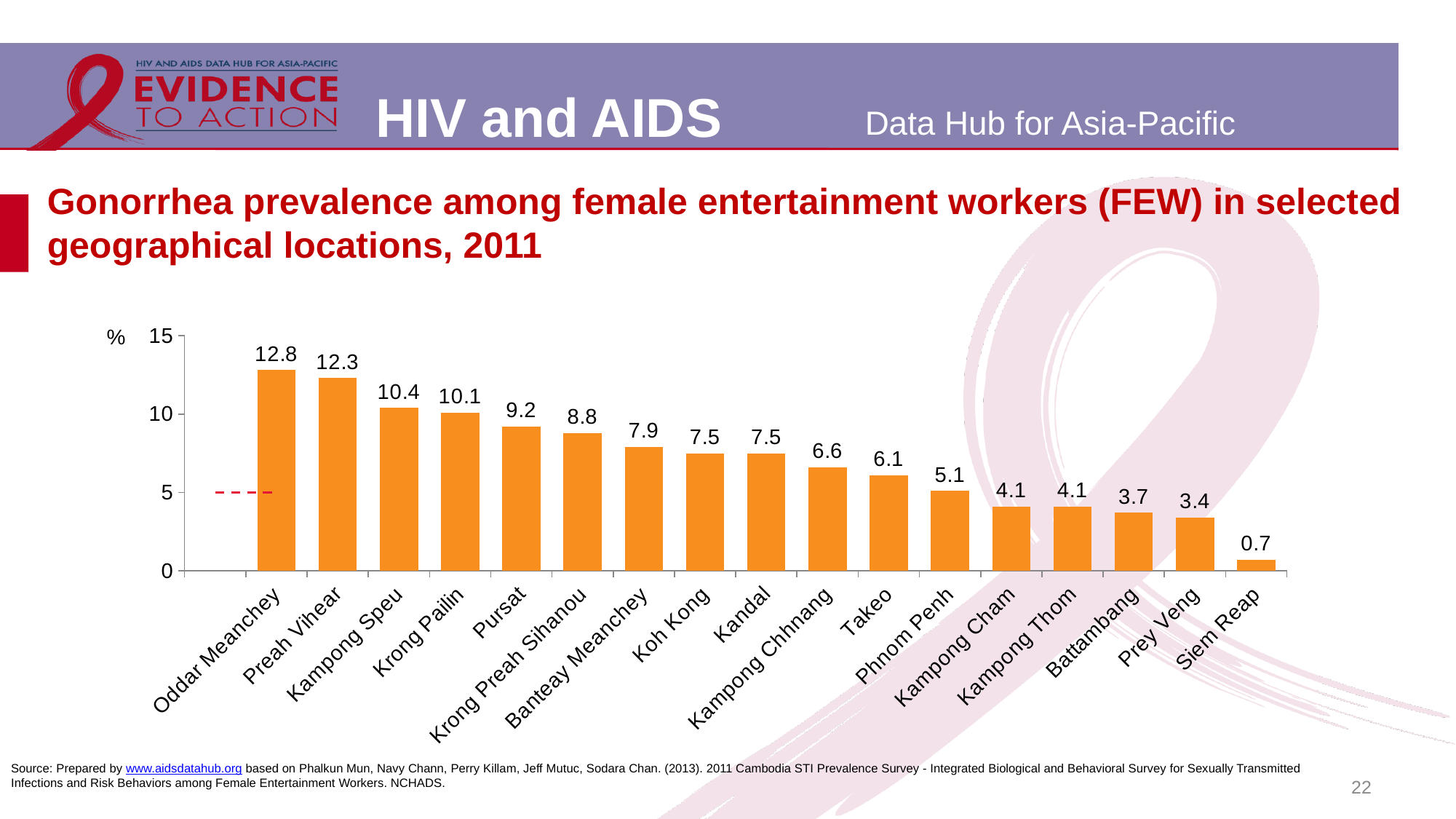
Which has a higher value, Pursat or Battambang? Pursat Which location has the lowest gonorrhea prevalence? Siem Reap What type of chart is used on this slide? Bar chart What is the difference between the values for Kampong Speu and Takeo? 4.3 Is the value for Krong Pailin greater or less than 10? greater What is the value shown for Siem Reap? 0.7 How many geographical locations are shown on the chart? 17 What is the gonorrhea prevalence among FEW in Oddar Meanchey? 12.8 Which location has the highest gonorrhea prevalence? Oddar Meanchey What is the difference between the values for Oddar Meanchey and Preah Vihear? 0.5 Do the values rise or fall moving from left to right along the x axis? Fall What is the value shown for Phnom Penh? 5.1